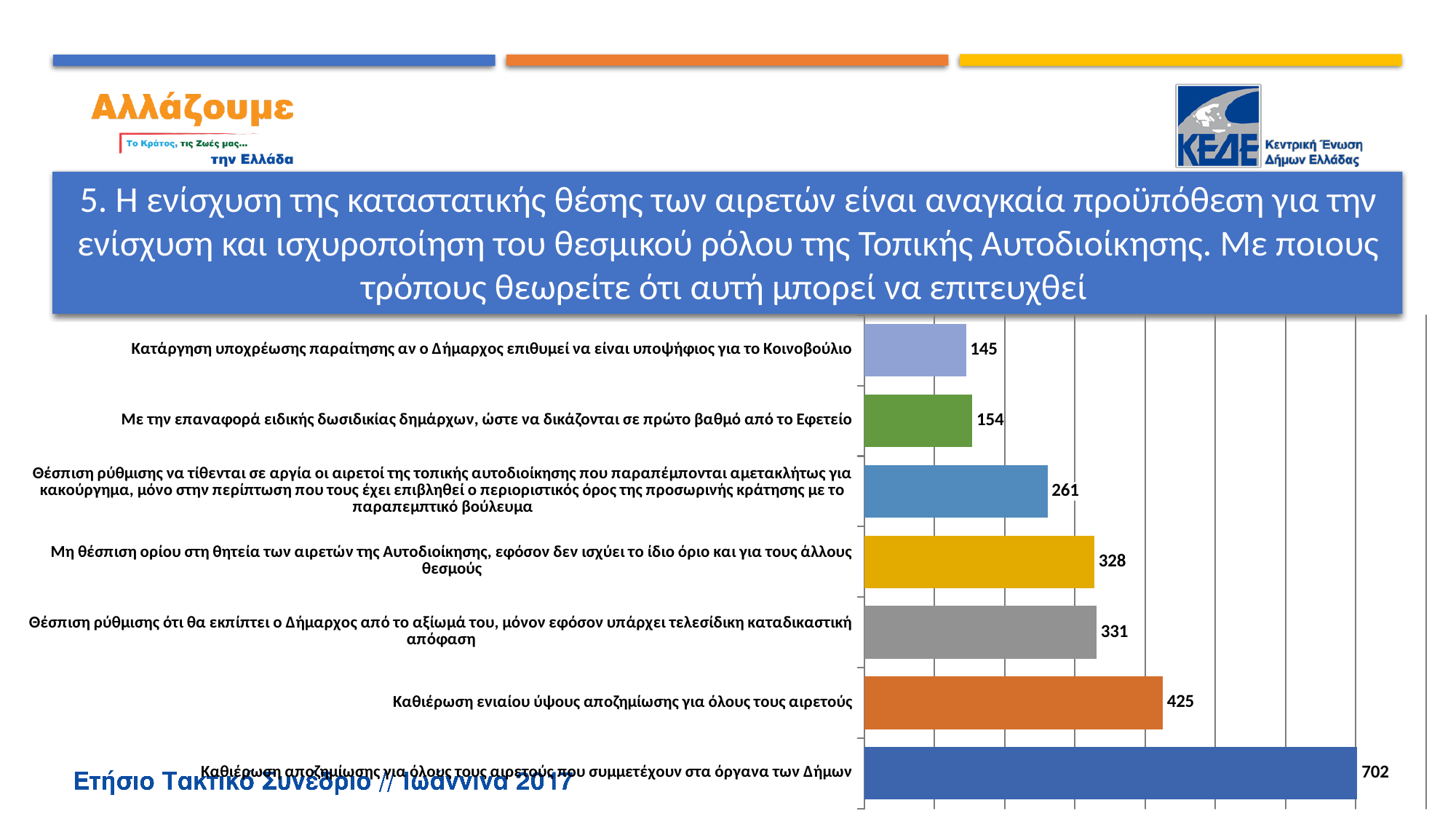
Which category has the highest value? Καθιέρωση αποζημίωσης για όλους τους αιρετούς που συμμετέχουν στα όργανα των Δήμων What value is shown for "Κατάργηση υποχρέωσης παραίτησης αν ο Δήμαρχος επιθυμεί να είναι υποψήφιος για το Κοινοβούλιο"? 145 What value is shown for "Με την επαναφορά ειδικής δωσιδικίας δημάρχων, ώστε να δικάζονται σε πρώτο βαθμό από το Εφετείο"? 154 What value is shown for "Καθιέρωση ενιαίου ύψους αποζημίωσης για όλους τους αιρετούς"? 425 What kind of chart is shown on the slide? Bar chart What colour is the bar with the value 702? Blue How many categories are shown in the chart? 7 Which is larger: the value for "Καθιέρωση ενιαίου ύψους αποζημίωσης για όλους τους αιρετούς" or the value for "Θέσπιση ρύθμισης να τίθενται σε αργία οι αιρετοί..."? Καθιέρωση ενιαίου ύψους αποζημίωσης για όλους τους αιρετούς Which category has the lowest value? Κατάργηση υποχρέωσης παραίτησης αν ο Δήμαρχος επιθυμεί να είναι υποψήφιος για το Κοινοβούλιο What is the difference between the values for "Θέσπιση ρύθμισης ότι θα εκπίπτει ο Δήμαρχος από το αξίωμά του..." (331) and "Θέσπιση ρύθμισης να τίθενται σε αργία οι αιρετοί..." (261)? 70 What is the difference between the highest value (702) and the value for "Καθιέρωση ενιαίου ύψους αποζημίωσης για όλους τους αιρετούς" (425)? 277 What value is shown for "Μη θέσπιση ορίου στη θητεία των αιρετών της Αυτοδιοίκησης, εφόσον δεν ισχύει το ίδιο όριο και για τους άλλους θεσμούς"? 328